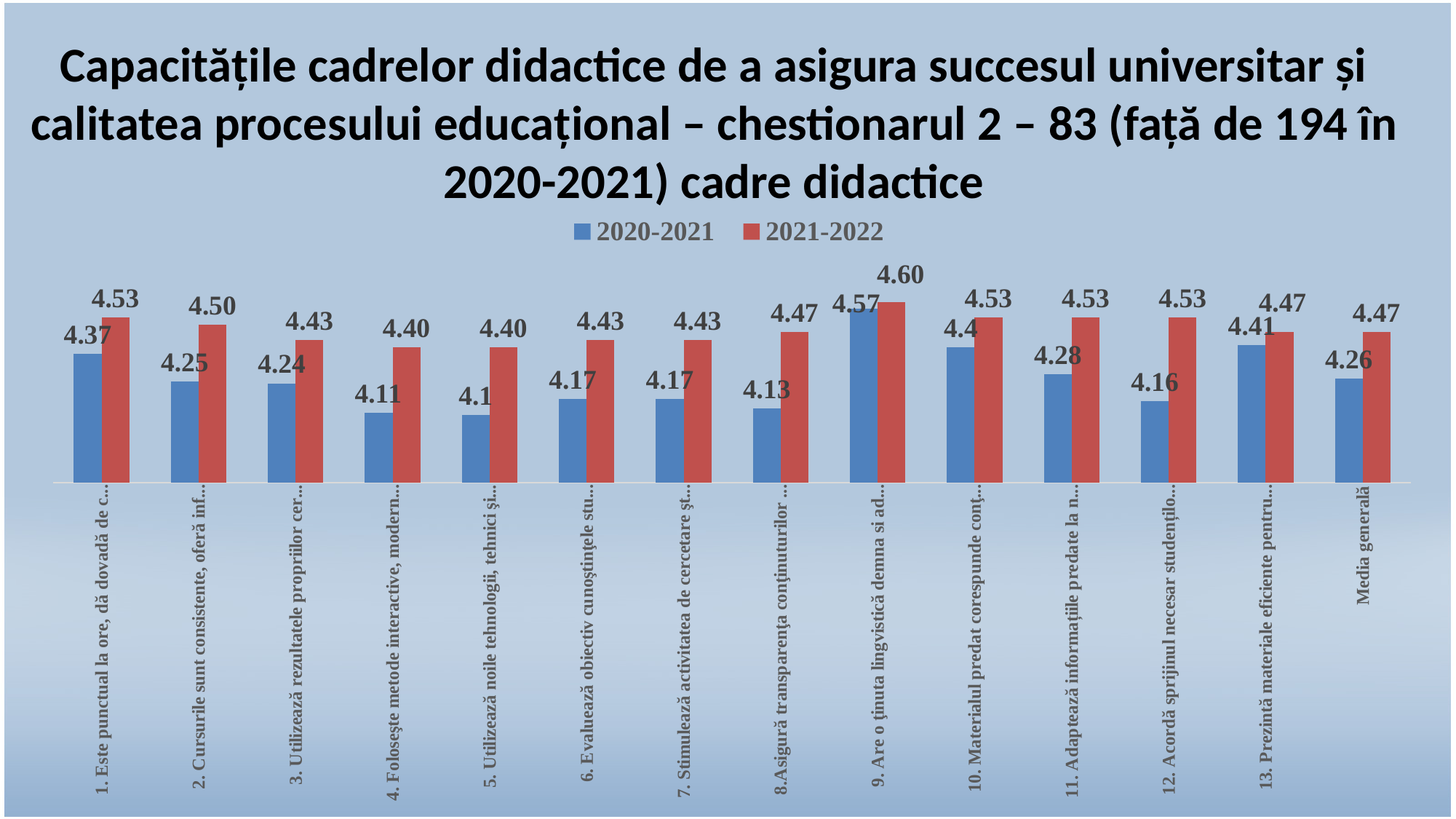
How many categories are plotted on the x axis? 14 What is the value for "Media generală" in the 2020-2021 series? 4.26 In the 2020-2021 series, which is larger: category 1 "Este punctual la ore..." or category 13 "Prezintă materiale eficiente pentru..."? 13. Prezintă materiale eficiente pentru... How many series does the legend list? 2 What kind of chart is shown on the slide? Bar chart What is the difference between the 2021-2022 and 2020-2021 values for "Media generală"? 0.21 What is the difference between the 2021-2022 and 2020-2021 values for category 12, "Acordă sprijinul necesar studenților..."? 0.37 What is the 2021-2022 value for category 9, "Are o ținuta lingvistică demna si ad..."? 4.60 What is the value for "Media generală" in the 2021-2022 series? 4.47 Which category has the lowest value in the 2020-2021 series? 5. Utilizează noile tehnologii, tehnici și... Which category has the highest value in the 2020-2021 series? 9. Are o ținuta lingvistică demna si ad... What is the 2020-2021 value for category 12, "Acordă sprijinul necesar studenților..."? 4.16